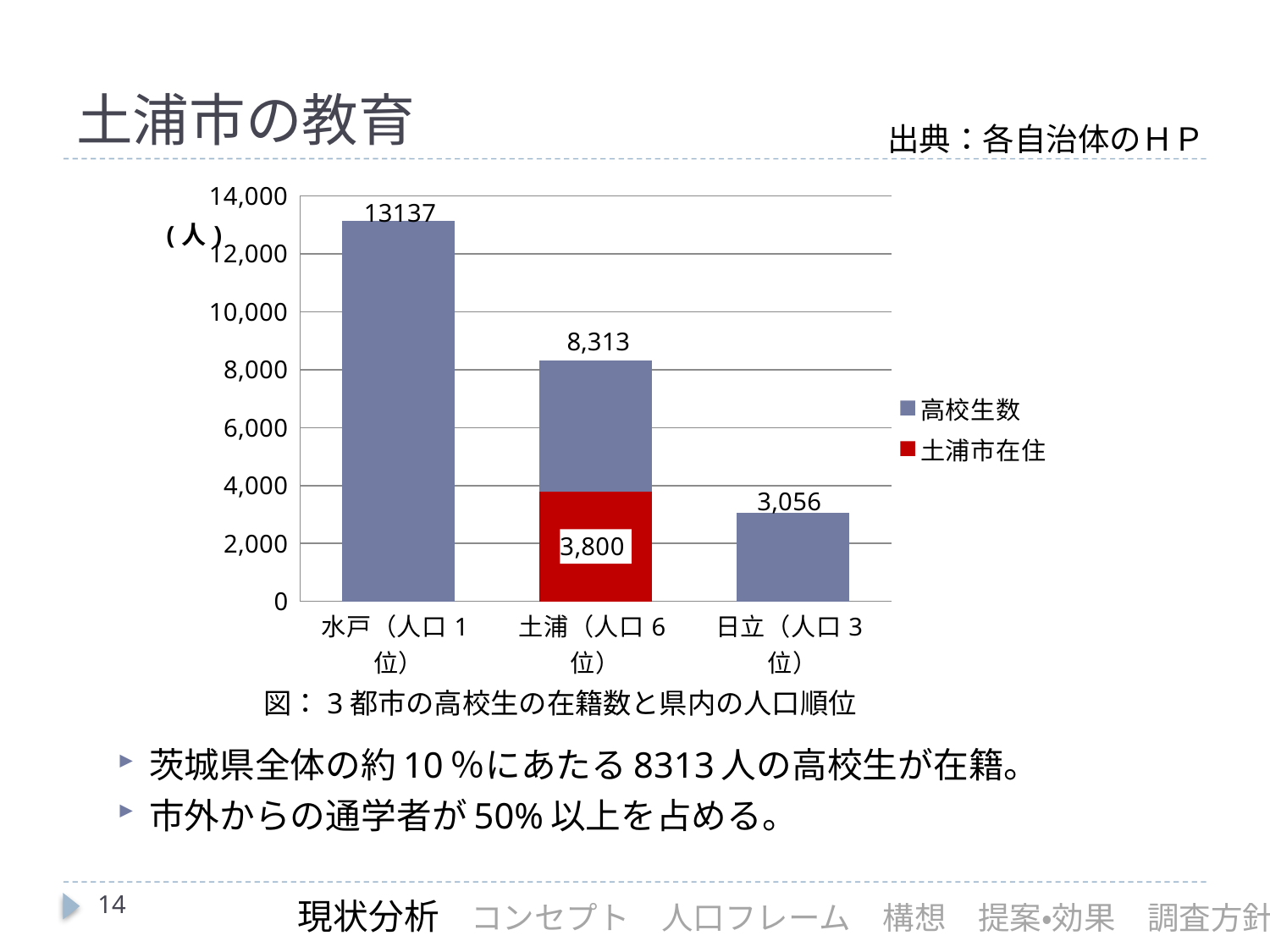
Which city has the highest number of high school students (高校生数)? 水戸（人口1位） Is the value for 日立（人口3位） greater or less than 4,000? less How many series does the chart legend list? 2 What value is labelled on the red 土浦市在住 segment of the 土浦 bar? 3,800 How many cities are shown on the x axis of the chart? 3 What is the value labelled at the top of the bar for 土浦（人口6位）? 8,313 What is the value labelled on the bar for 日立（人口3位）? 3,056 Which city has the lowest number of high school students (高校生数)? 日立（人口3位） What kind of chart is shown on the slide? bar chart What is the difference between the 高校生数 values for 土浦 and 日立? 5,257 What is the value labelled on the bar for 水戸（人口1位）? 13137 Which is larger, the 高校生数 value for 水戸 or for 土浦? 水戸